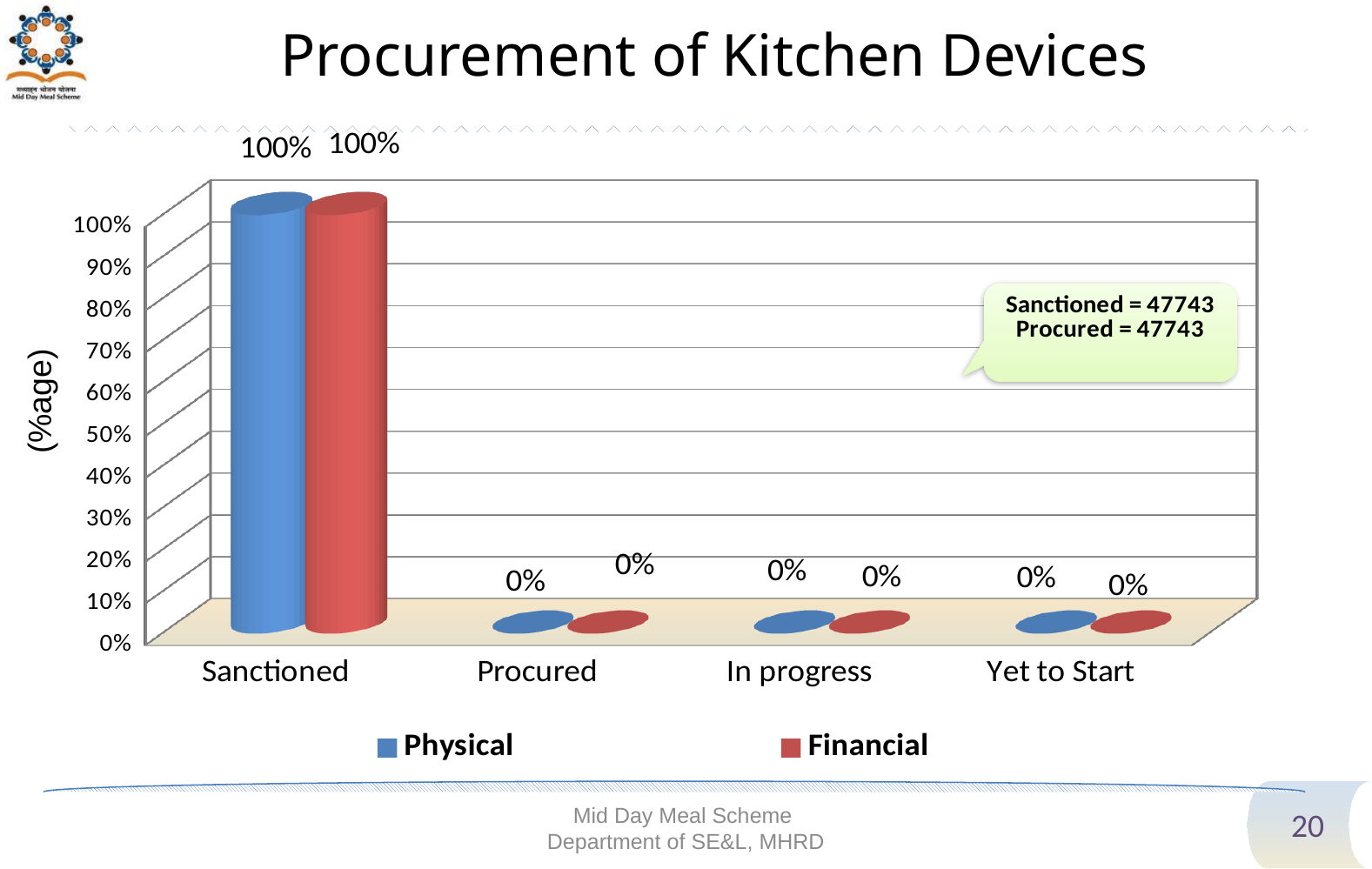
What is the title of the chart? Procurement of Kitchen Devices How many categories are shown on the x axis? 4 What kind of chart is shown on the slide? Bar chart According to the callout on the chart, what is the Sanctioned number? 47743 What is the Financial value for Yet to Start? 0% What is the Physical value for Procured? 0% How many series does the legend list? 2 Which category has the highest Physical value? Sanctioned What is the difference between the Physical values for Sanctioned and In progress? 100% What is the Financial value for Sanctioned? 100% Which is larger, the Financial value for Sanctioned or the Financial value for Procured? Sanctioned What is the Physical value for Sanctioned? 100%